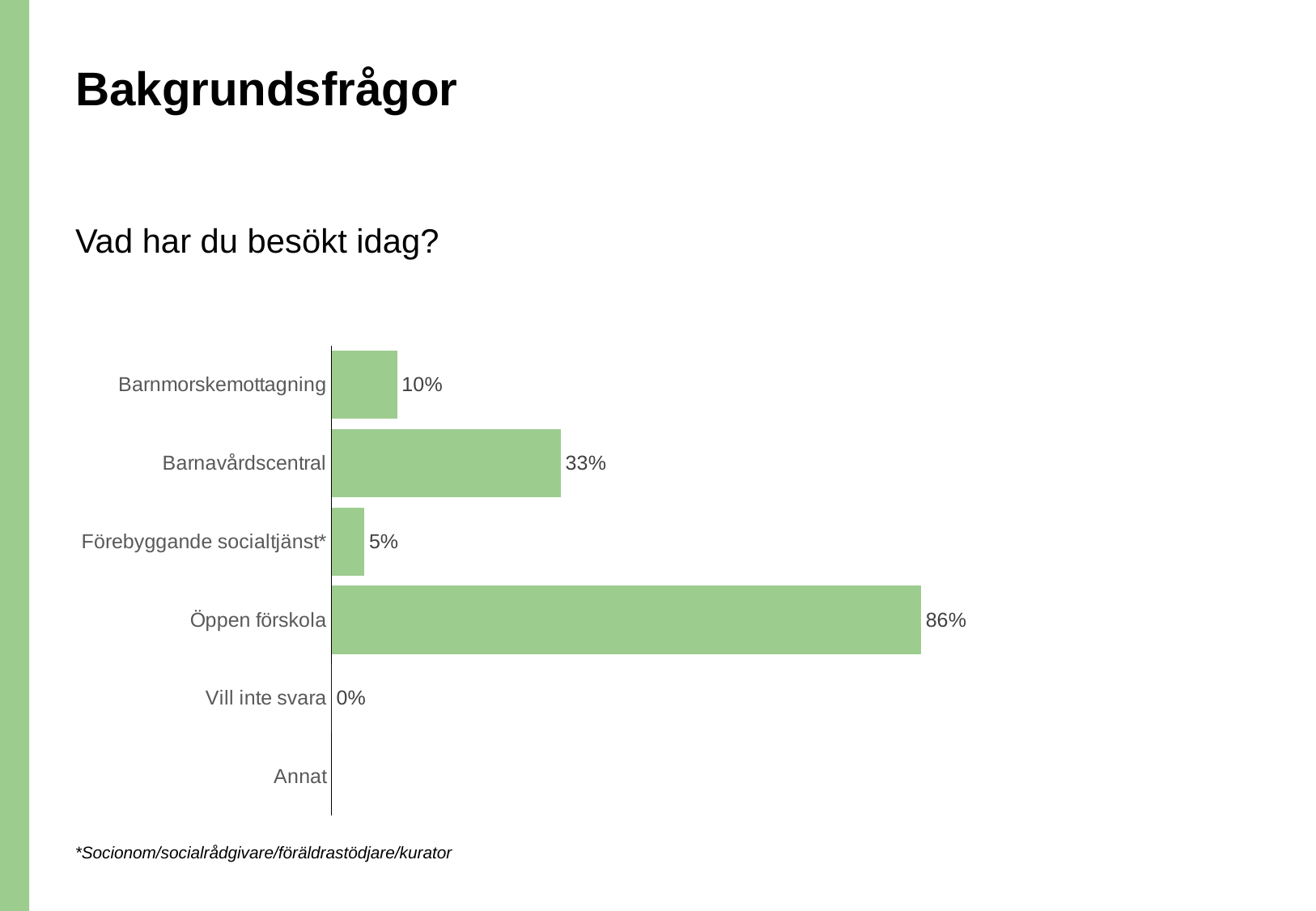
How many categories are listed on the chart? 6 What is the value for Öppen förskola? 86% What is the value for Barnmorskemottagning? 10% What question does the chart answer, as written above it? Vad har du besökt idag? What is the difference between the values for Barnmorskemottagning and Förebyggande socialtjänst*? 5% What kind of chart is shown on the slide? Bar chart Which is larger, the value for Barnavårdscentral or the value for Barnmorskemottagning? Barnavårdscentral What is the value for Vill inte svara? 0% What is the difference between the values for Öppen förskola and Barnavårdscentral? 53% What is the value for Förebyggande socialtjänst*? 5% Which category has the highest value? Öppen förskola What is the value for Barnavårdscentral? 33%